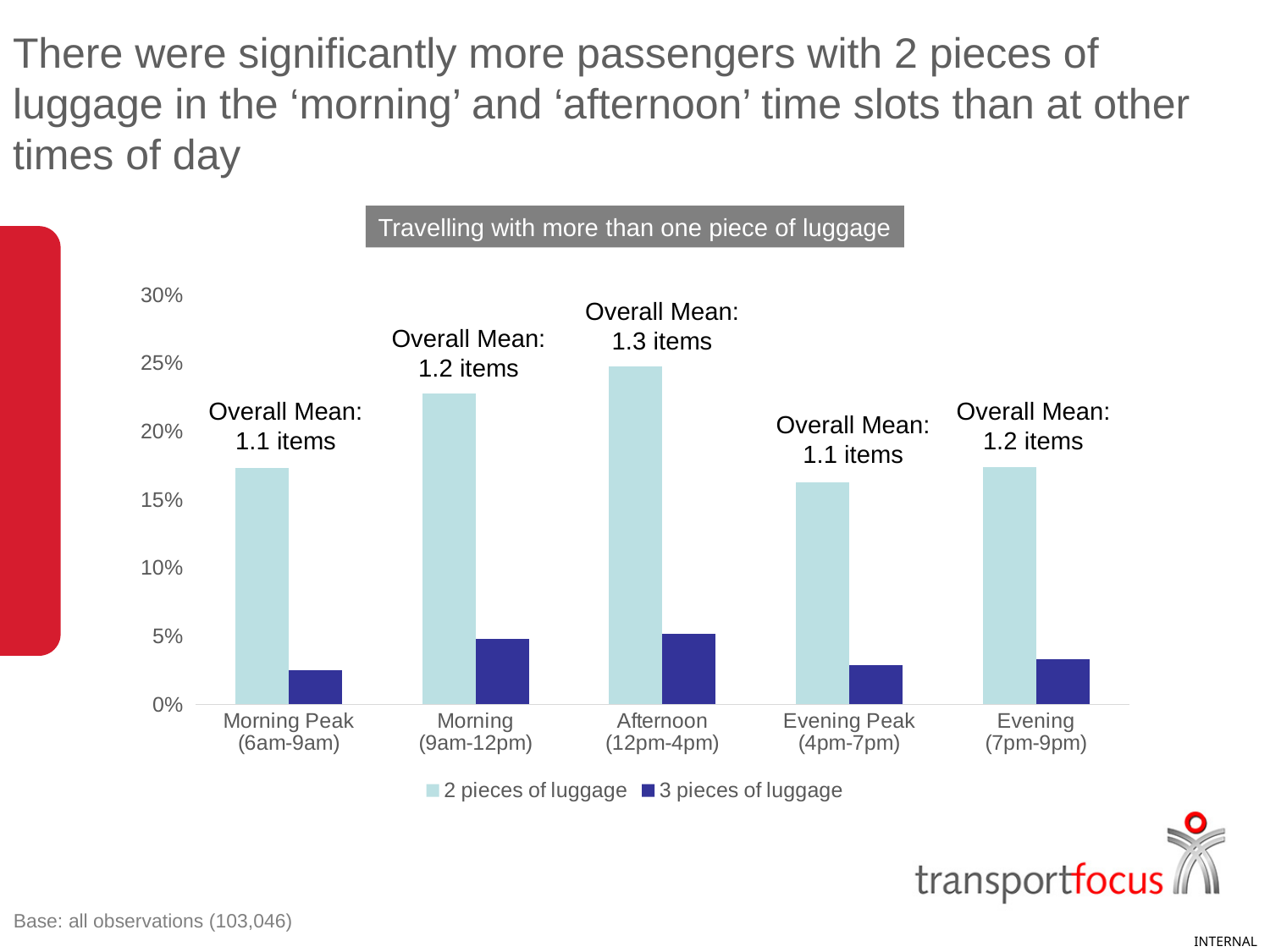
How many series does the legend list? 2 Which is larger for 2 pieces of luggage: Morning (9am-12pm) or Evening Peak (4pm-7pm)? Morning (9am-12pm) What is the title of the chart? Travelling with more than one piece of luggage Which time slot has the highest value for 2 pieces of luggage? Afternoon (12pm-4pm) How many time-slot categories are shown on the x axis? 5 Is the value for 3 pieces of luggage in the Morning (9am-12pm) slot greater or less than 10%? less Which is larger for 3 pieces of luggage: Afternoon (12pm-4pm) or Morning Peak (6am-9am)? Afternoon (12pm-4pm) Is the value for 2 pieces of luggage in the Afternoon (12pm-4pm) slot greater or less than 20%? greater What kind of chart is shown on the slide? Bar chart Is the value for 2 pieces of luggage in the Morning Peak (6am-9am) slot greater or less than 20%? less What is the Overall Mean number of items shown for the Morning Peak (6am-9am) slot? 1.1 items What is the Overall Mean number of items shown for the Afternoon (12pm-4pm) slot? 1.3 items